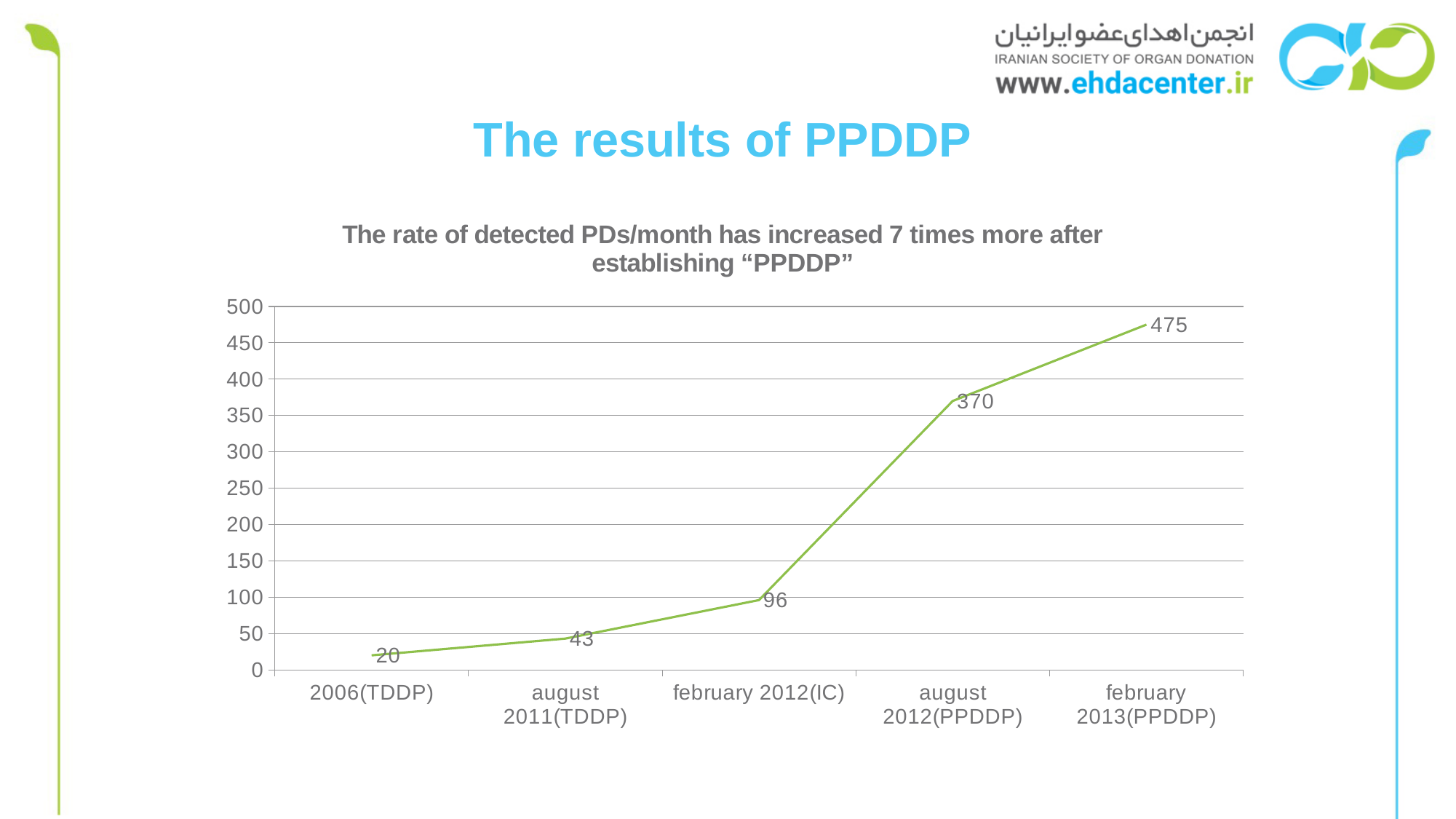
Do the values rise or fall along the x axis from 2006(TDDP) to february 2013(PPDDP)? rise What is the value for august 2012(PPDDP)? 370 Which is larger, the value for february 2012(IC) or the value for august 2011(TDDP)? february 2012(IC) Which category has the lowest value? 2006(TDDP) What is the value for february 2013(PPDDP)? 475 What kind of chart is shown on the slide? line chart What is the value for 2006(TDDP)? 20 How many data points are plotted on the chart? 5 Which category has the highest value? february 2013(PPDDP) What is the difference between the values for february 2013(PPDDP) and august 2012(PPDDP)? 105 What is the value for february 2012(IC)? 96 What is the difference between the values for august 2011(TDDP) and 2006(TDDP)? 23